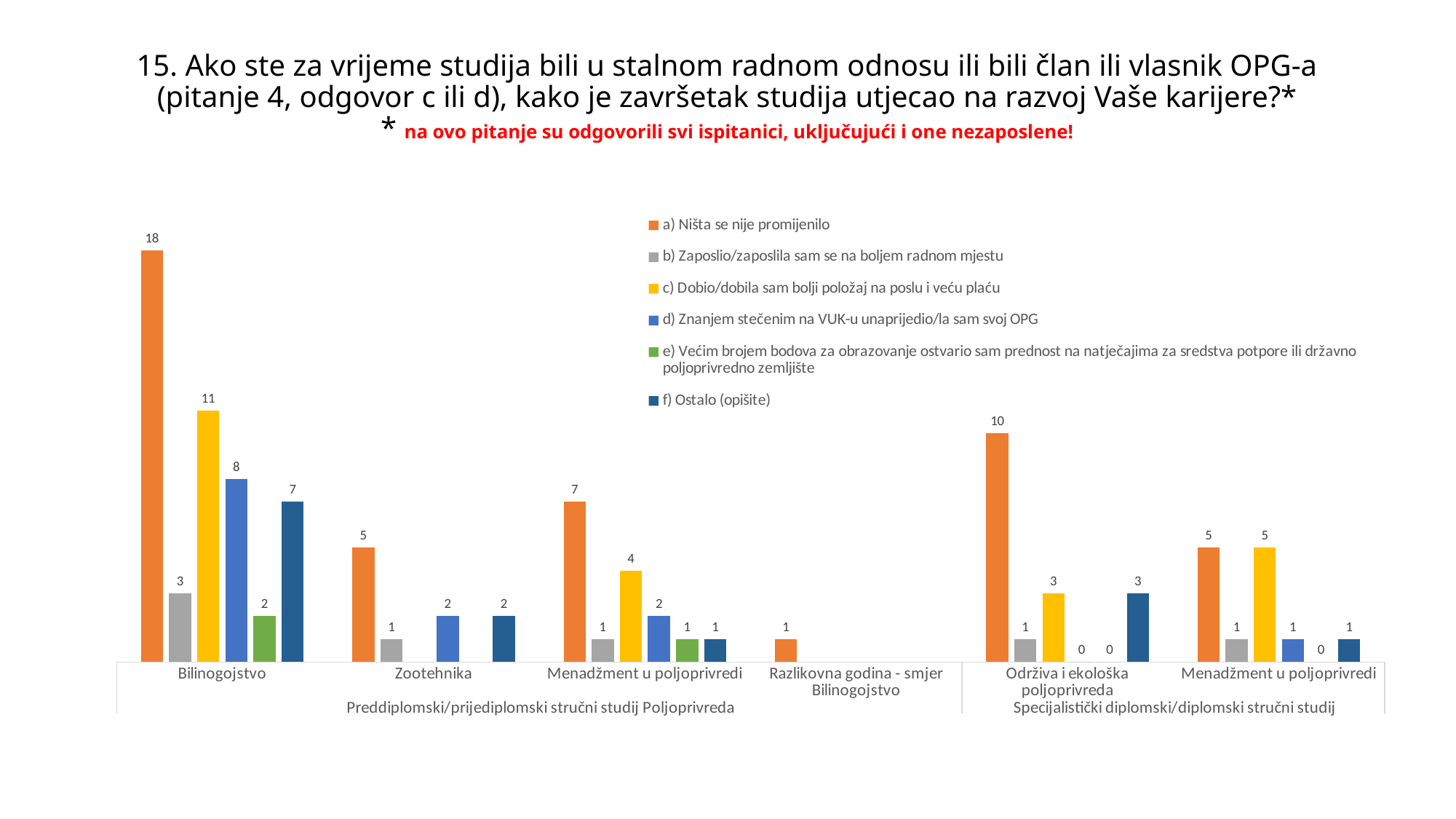
In the Održiva i ekološka poljoprivreda category, which is larger: the value for 'a) Ništa se nije promijenilo' or the value for 'f) Ostalo (opišite)'? a) Ništa se nije promijenilo What is the value for 'a) Ništa se nije promijenilo' in the Bilinogojstvo category? 18 Which category has the lowest value for 'a) Ništa se nije promijenilo'? Razlikovna godina - smjer Bilinogojstvo What kind of chart is shown on the slide? Bar chart Which category has the highest value for 'a) Ništa se nije promijenilo'? Bilinogojstvo What is the difference between the 'a) Ništa se nije promijenilo' value and the 'c) Dobio/dobila sam bolji položaj na poslu i veću plaću' value in the Bilinogojstvo category? 7 What is the value for 'a) Ništa se nije promijenilo' in the Održiva i ekološka poljoprivreda category? 10 How many series does the legend list? 6 What is the value for 'd) Znanjem stečenim na VUK-u unaprijedio/la sam svoj OPG' in the Zootehnika category? 2 Which colour represents the series 'c) Dobio/dobila sam bolji položaj na poslu i veću plaću'? Yellow What is the value for 'f) Ostalo (opišite)' in the Menadžment u poljoprivredi category under Preddiplomski/prijediplomski stručni studij Poljoprivreda? 1 What is the value for 'c) Dobio/dobila sam bolji položaj na poslu i veću plaću' in the Bilinogojstvo category? 11